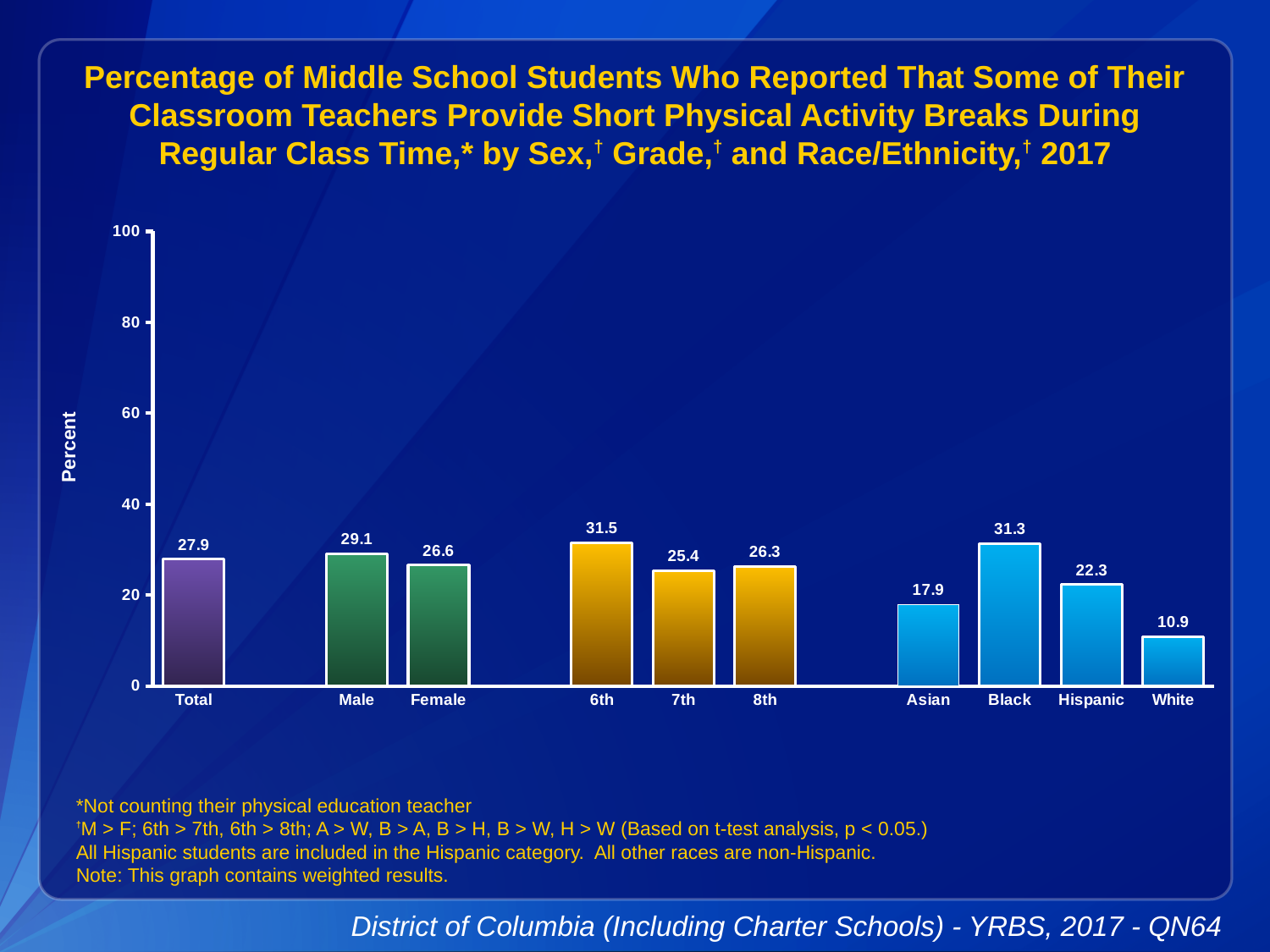
Which category has the lowest value? White Which category has the highest value? 6th What is the value for Female? 26.6 What kind of chart is this? bar chart What is the label on the y axis? Percent Is the value for Black greater or less than 20? greater What is the value for Total? 27.9 What is the value for Hispanic? 22.3 How many categories are shown on the x axis? 10 What is the difference between the values for Male and Female? 2.5 Which is larger, the value for 6th or the value for 7th? 6th What is the difference between the values for Black and Asian? 13.4